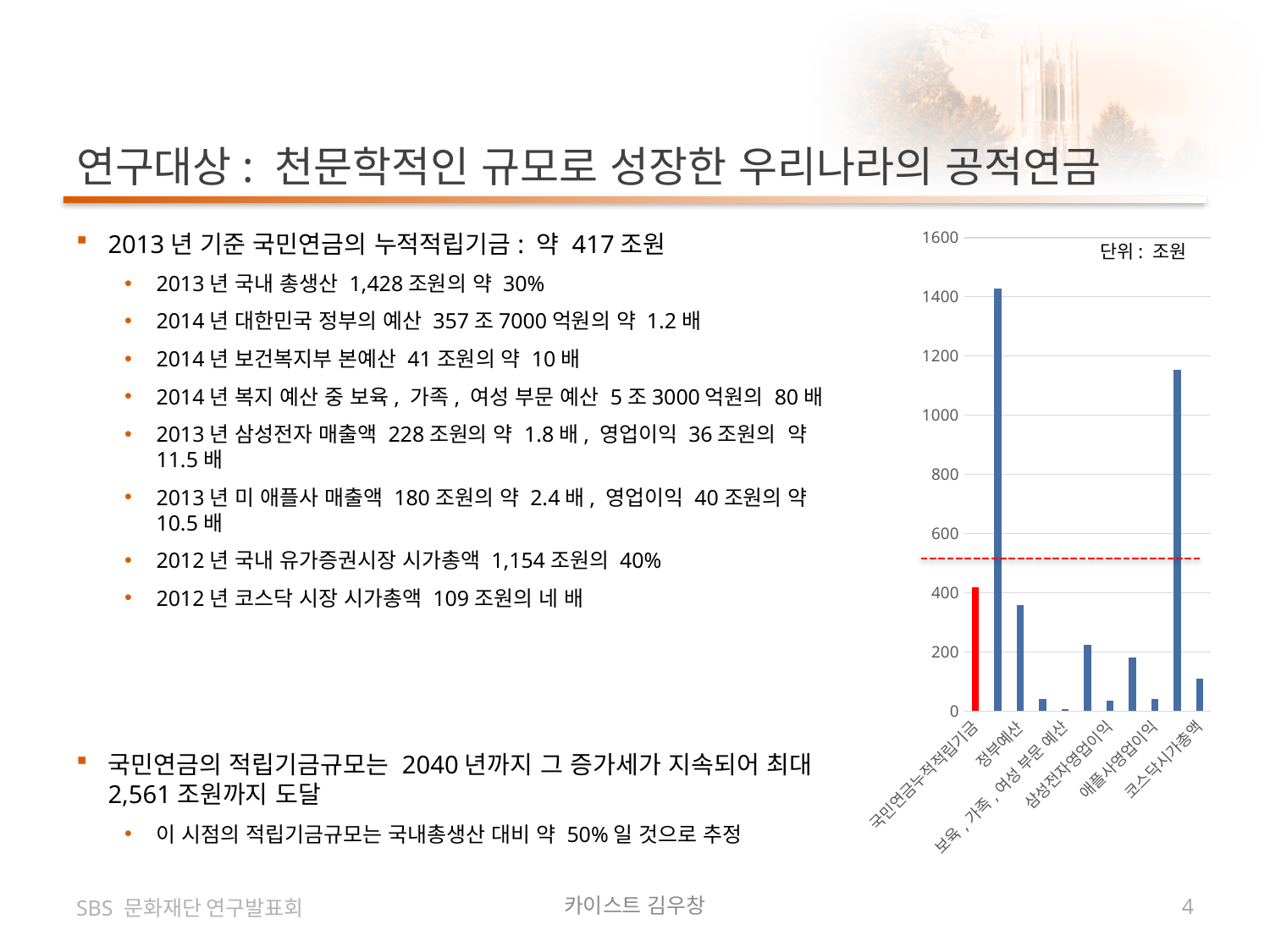
Which bar in the chart is coloured red? 국민연금누적적립기금 Which is larger, the value for 국민연금누적적립기금 or the value for 정부예산? 국민연금누적적립기금 How many bars are plotted in the chart? 11 Among the labelled categories, which has the lowest value? 보육, 가족, 여성 부문 예산 Is the value for 삼성전자영업이익 greater or less than 200? less What kind of chart is shown on the slide? bar chart Which is larger, the value for 정부예산 or the value for 코스닥시가총액? 정부예산 Is the value for 국민연금누적적립기금 greater or less than 600? less What unit does the chart state its values are in? 조원 Is the value for 국민연금누적적립기금 greater or less than 200? greater